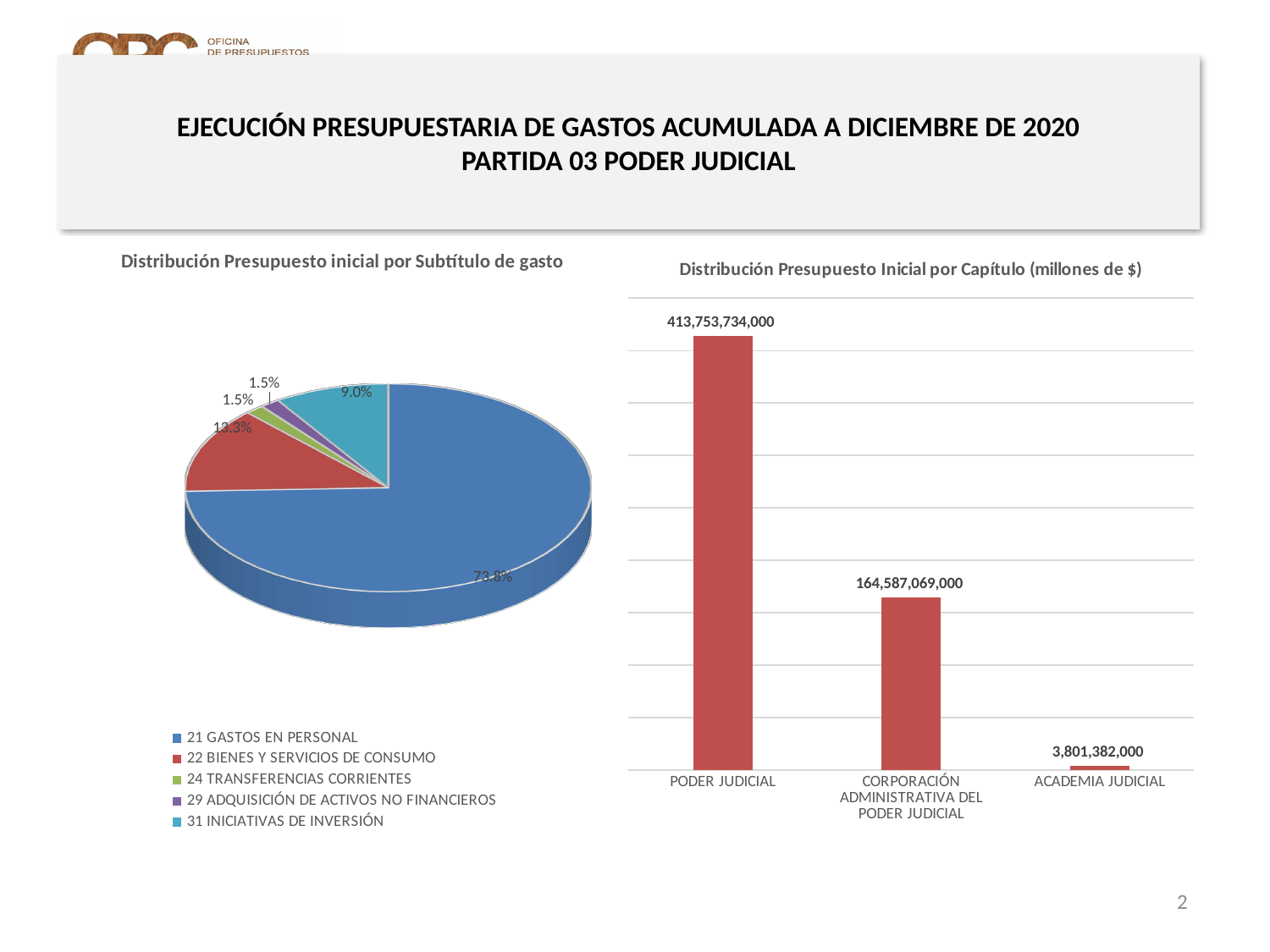
In the bar chart 'Distribución Presupuesto Inicial por Capítulo (millones de $)', what is the value for CORPORACIÓN ADMINISTRATIVA DEL PODER JUDICIAL? 164,587,069,000 In the pie chart 'Distribución Presupuesto inicial por Subtítulo de gasto', what share does 21 GASTOS EN PERSONAL have? 73.8% What kind of chart is 'Distribución Presupuesto Inicial por Capítulo (millones de $)'? Bar chart In the bar chart 'Distribución Presupuesto Inicial por Capítulo (millones de $)', which category has the lowest value? ACADEMIA JUDICIAL In the bar chart 'Distribución Presupuesto Inicial por Capítulo (millones de $)', which category has the highest value? PODER JUDICIAL In the bar chart 'Distribución Presupuesto Inicial por Capítulo (millones de $)', how many categories are shown? 3 In the bar chart 'Distribución Presupuesto Inicial por Capítulo (millones de $)', what is the value for ACADEMIA JUDICIAL? 3,801,382,000 How many entries does the legend of the pie chart 'Distribución Presupuesto inicial por Subtítulo de gasto' list? 5 In the bar chart 'Distribución Presupuesto Inicial por Capítulo (millones de $)', what is the difference between the values for PODER JUDICIAL and CORPORACIÓN ADMINISTRATIVA DEL PODER JUDICIAL? 249,166,665,000 In the pie chart 'Distribución Presupuesto inicial por Subtítulo de gasto', what share does 31 INICIATIVAS DE INVERSIÓN have? 9.0% In the pie chart 'Distribución Presupuesto inicial por Subtítulo de gasto', what share does 22 BIENES Y SERVICIOS DE CONSUMO have? 13.3% In the bar chart 'Distribución Presupuesto Inicial por Capítulo (millones de $)', what is the value for PODER JUDICIAL? 413,753,734,000